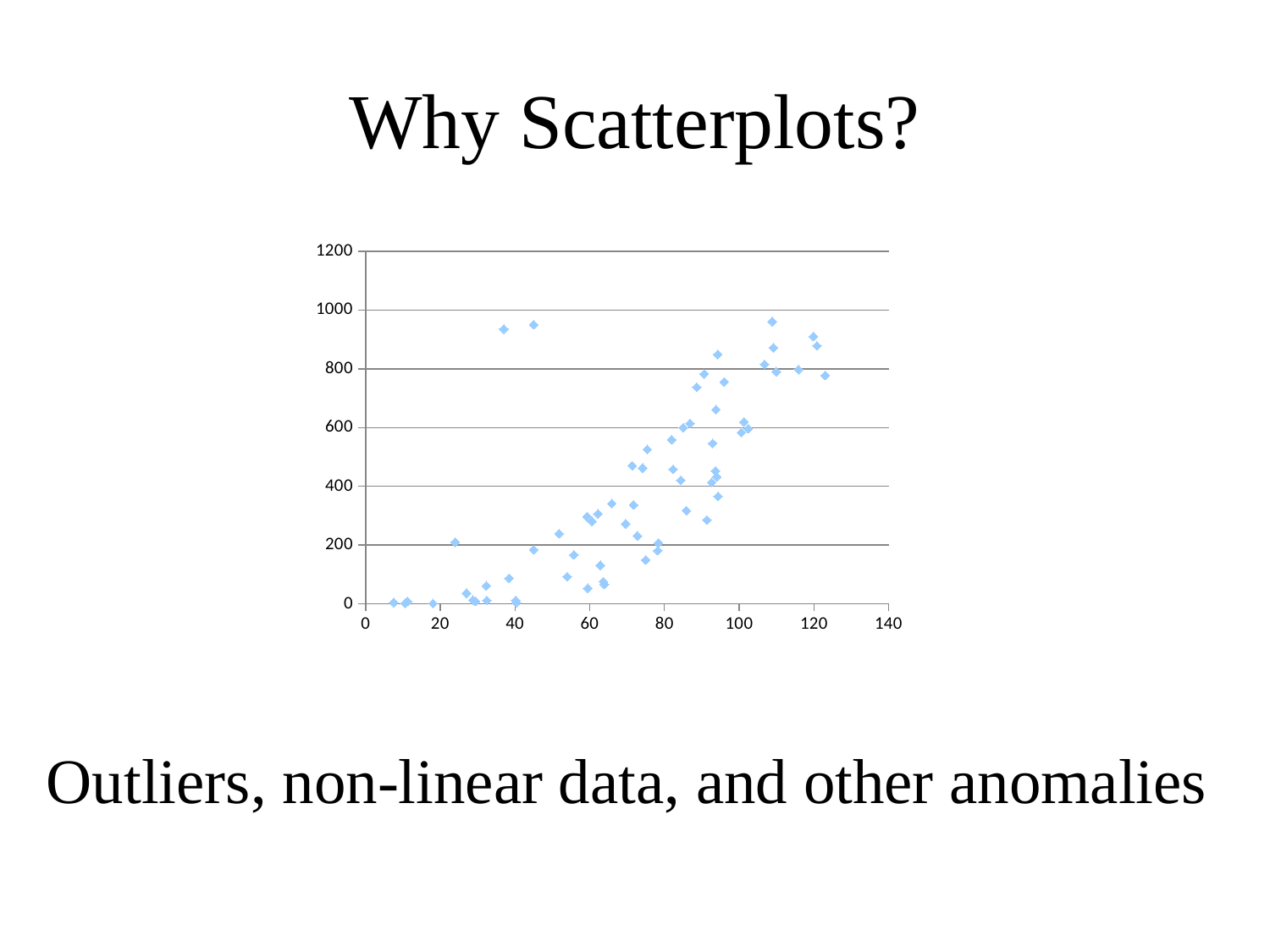
Are the points plotted near x = 10 greater or less than 200 on the y-axis? less Is the highest plotted point on the chart greater or less than 800 on the y-axis? greater What kind of chart is shown on the slide? scatter plot Is the point plotted near x = 60 with the lowest y value greater or less than 200? less What is the highest value shown on the y-axis? 1200 Do the plotted values generally rise or fall as the x-axis value increases? rise What is the highest value shown on the x-axis? 140